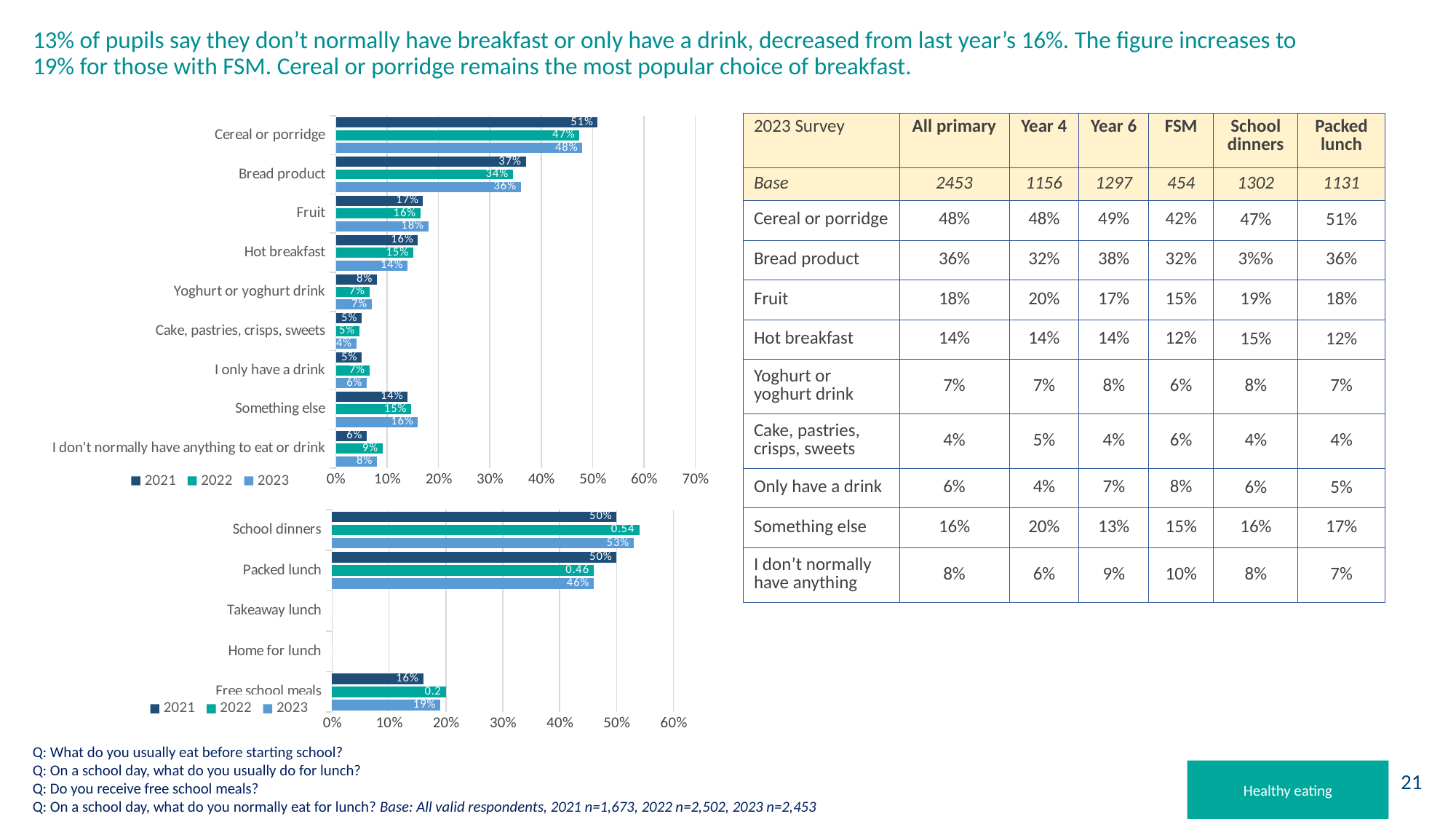
In the bottom chart, what is the 2022 value for Free school meals? 0.2 In the top chart, what is the 2023 value for Cereal or porridge? 48% What kind of chart is the bottom chart? Bar chart In the top chart, what is the 2021 value for Bread product? 37% In the top chart, which category has the lowest 2023 value? Cake, pastries, crisps, sweets In the top chart, which is larger for Fruit: the 2022 value or the 2023 value? 2023 In the bottom chart, what is the 2023 value for School dinners? 53% In the top chart, which category has the highest 2023 value? Cereal or porridge In the bottom chart, is the 2023 value for Packed lunch greater or less than 50%? less In the top chart, how many categories are shown on the vertical axis? 9 In the top chart, how many series does the legend list? 3 In the top chart, what is the difference between the 2021 and 2023 values for Cereal or porridge? 3%